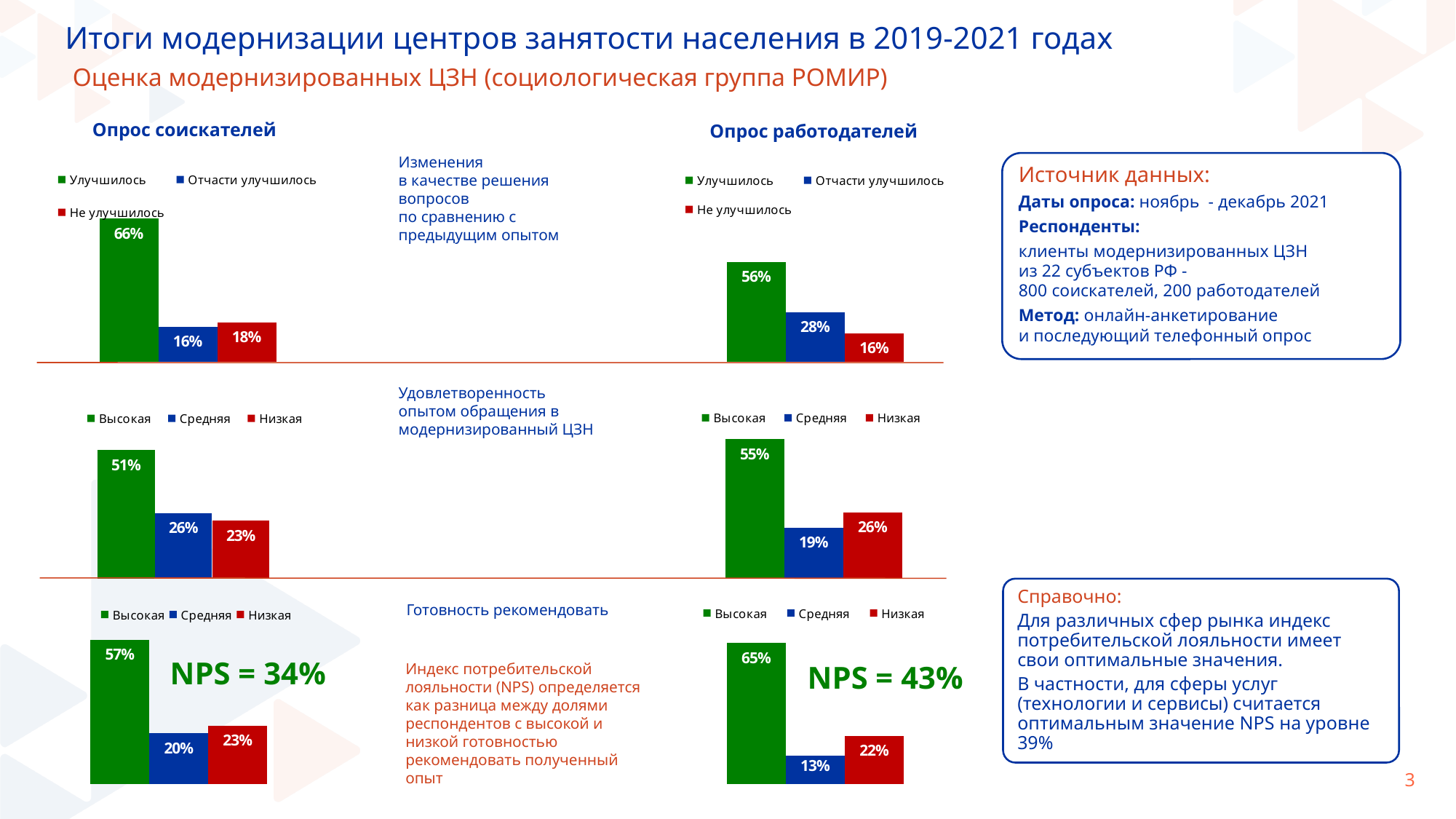
What NPS value is shown next to the 'Опрос соискателей' chart for 'Готовность рекомендовать'? NPS = 34% What kind of chart is used for 'Удовлетворенность опытом обращения в модернизированный ЦЗН' under 'Опрос соискателей'? Bar chart In the 'Опрос работодателей' chart for 'Удовлетворенность опытом обращения в модернизированный ЦЗН', what is the value for 'Средняя'? 19% In the 'Опрос соискателей' chart for 'Изменения в качестве решения вопросов по сравнению с предыдущим опытом', what is the value for 'Улучшилось'? 66% How many series does the legend list in the 'Опрос работодателей' chart for 'Готовность рекомендовать'? 3 In the 'Опрос соискателей' chart for 'Изменения в качестве решения вопросов', which category has the highest value? Улучшилось In the 'Опрос соискателей' chart for 'Удовлетворенность опытом обращения в модернизированный ЦЗН', which category has the lowest value? Низкая In the 'Опрос работодателей' chart for 'Готовность рекомендовать', what is the difference between 'Высокая' and 'Низкая'? 43% In the 'Опрос работодателей' chart for 'Изменения в качестве решения вопросов', what is the difference between 'Улучшилось' and 'Не улучшилось'? 40% In the 'Опрос соискателей' chart for 'Готовность рекомендовать', which is larger: 'Средняя' or 'Низкая'? Низкая In the 'Опрос соискателей' chart for 'Удовлетворенность опытом обращения в модернизированный ЦЗН', what colour is the 'Высокая' bar? Green In the 'Опрос работодателей' chart for 'Изменения в качестве решения вопросов по сравнению с предыдущим опытом', what is the value for 'Отчасти улучшилось'? 28%